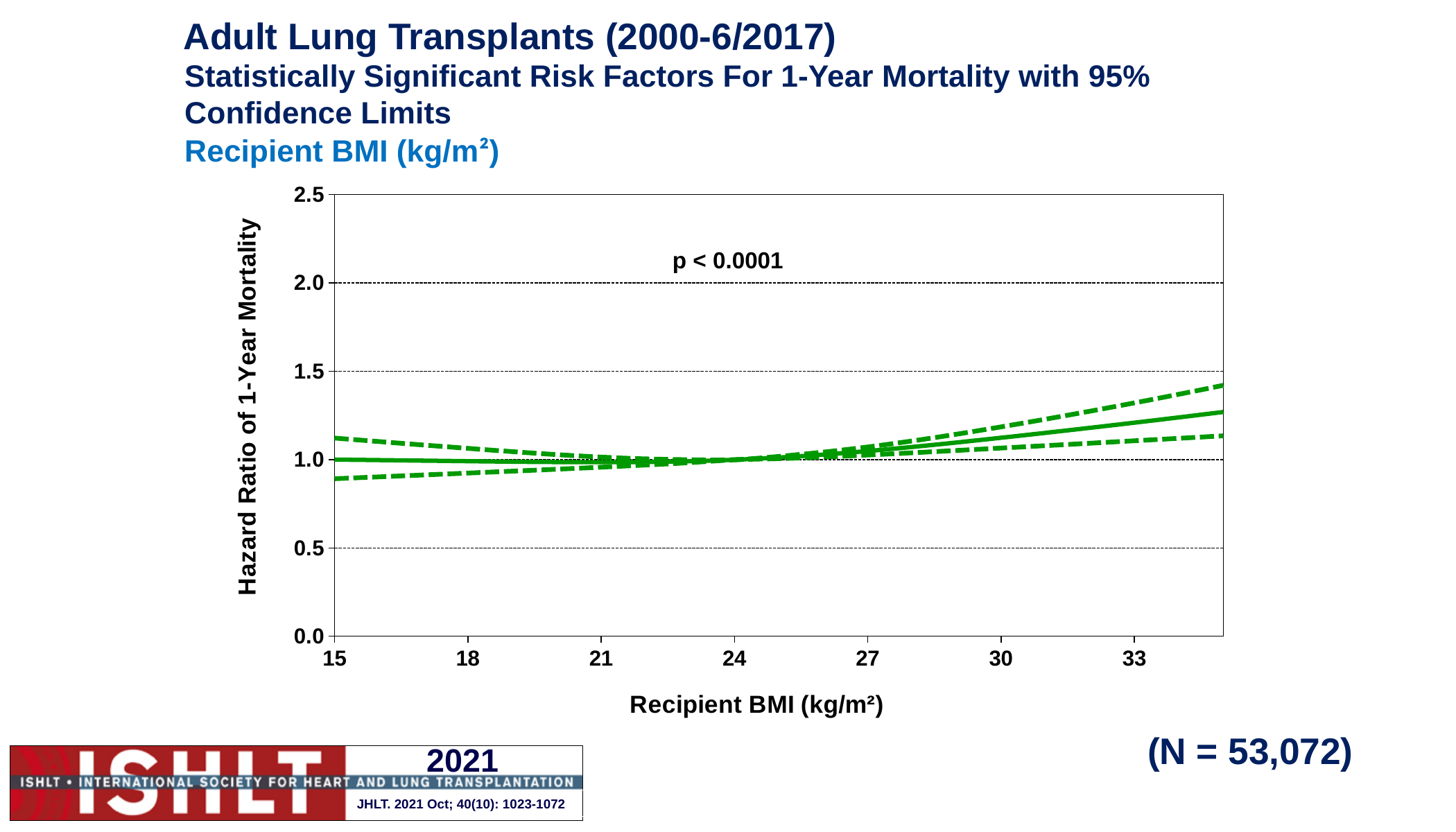
What p-value is printed on the chart? p < 0.0001 How many tick labels are shown on the x axis? 7 Does the solid hazard ratio line rise or fall as recipient BMI increases from 27 to 33? rise Is the lower dashed confidence limit at a recipient BMI of 15 greater or less than 1.0? less Is the solid hazard ratio line at a recipient BMI of 33 greater or less than 1.0? greater Is the upper dashed confidence limit at the right end of the chart greater or less than 1.5? less What kind of chart is shown on the slide? line chart Which is larger at a recipient BMI of 33: the upper dashed confidence limit or the lower dashed confidence limit? upper dashed confidence limit How many lines are plotted on the chart? 3 What sample size (N) is shown on the slide? N = 53,072